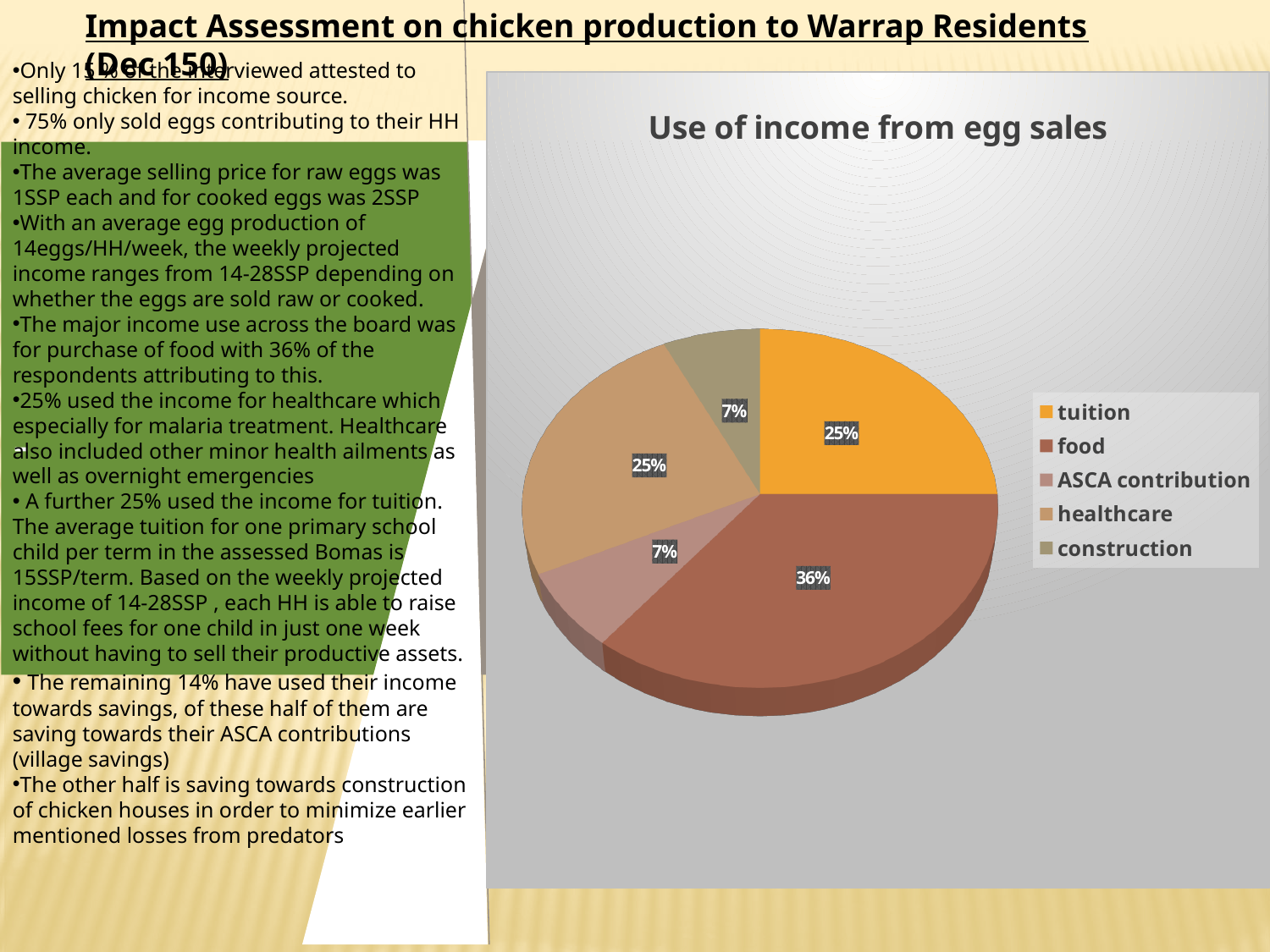
What is the title of the chart? Use of income from egg sales Which use of income has the largest share of the pie? food How many entries does the legend list? 5 What percentage of income from egg sales goes to ASCA contribution? 7% What percentage of income from egg sales is used for tuition? 25% Which is larger, the share for food or the share for tuition? food What percentage of income from egg sales is used for healthcare? 25% What percentage of income from egg sales is used for food? 36% What is the difference between the share for food and the share for healthcare? 11% What kind of chart is shown on the slide? pie chart What is the combined share of tuition and healthcare? 50% How many categories does the pie chart show? 5